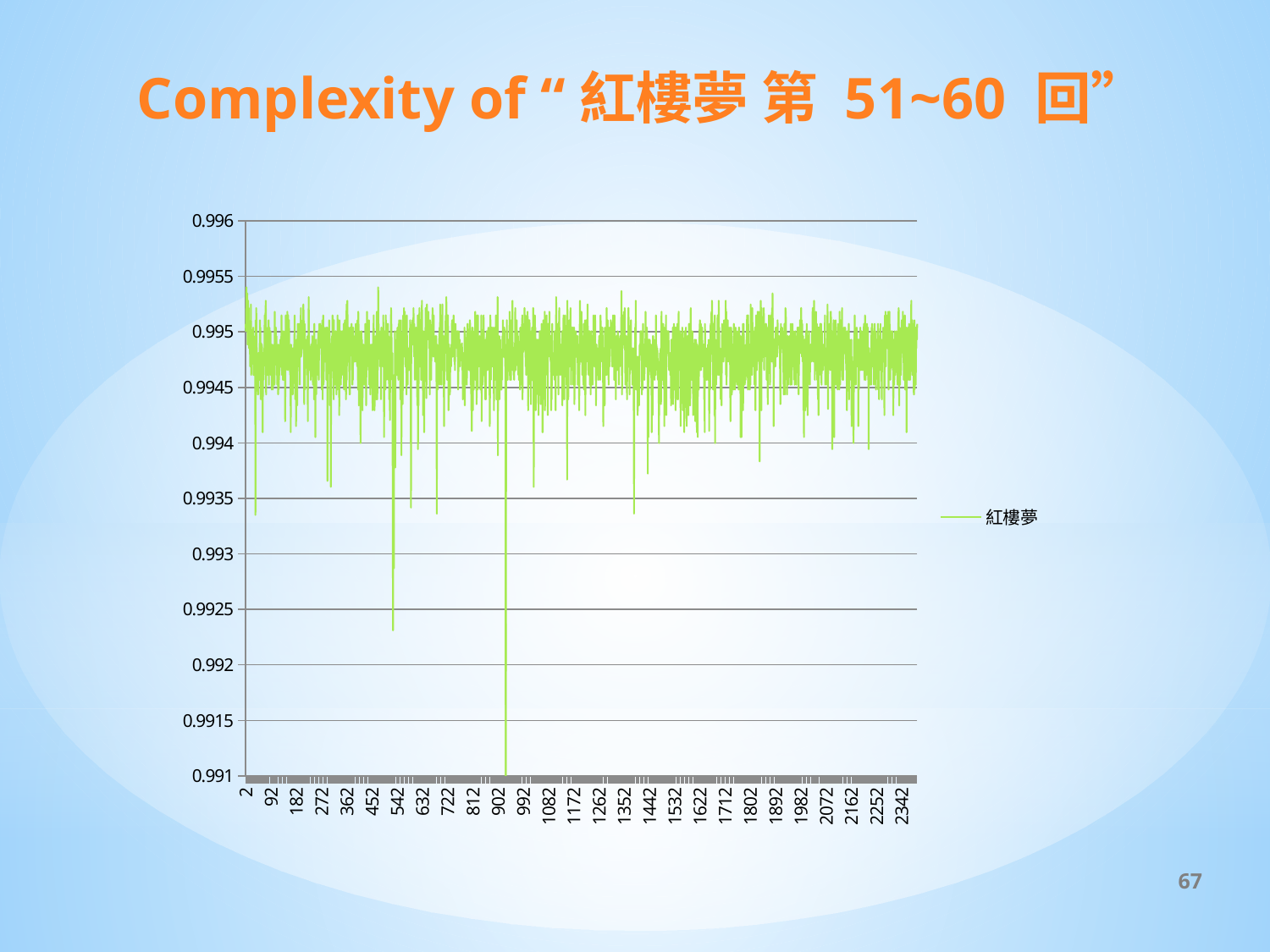
What is the highest value shown on the y axis? 0.996 What is the lowest value shown on the y axis? 0.991 What kind of chart is shown on the slide? line chart How many series does the legend list? 1 What is the last label on the x axis? 2342 What is the title of the slide containing the chart? Complexity of "紅樓夢 第 51~60 回" What is the name of the series shown in the legend? 紅樓夢 What is the first label on the x axis? 2 Is the dip near x = 542 greater or less than 0.993? less Do the values show a clear rising or falling trend along the x axis, or do they stay roughly level? roughly level Is the deepest dip of the line (near x = 902) greater or less than 0.9915? less